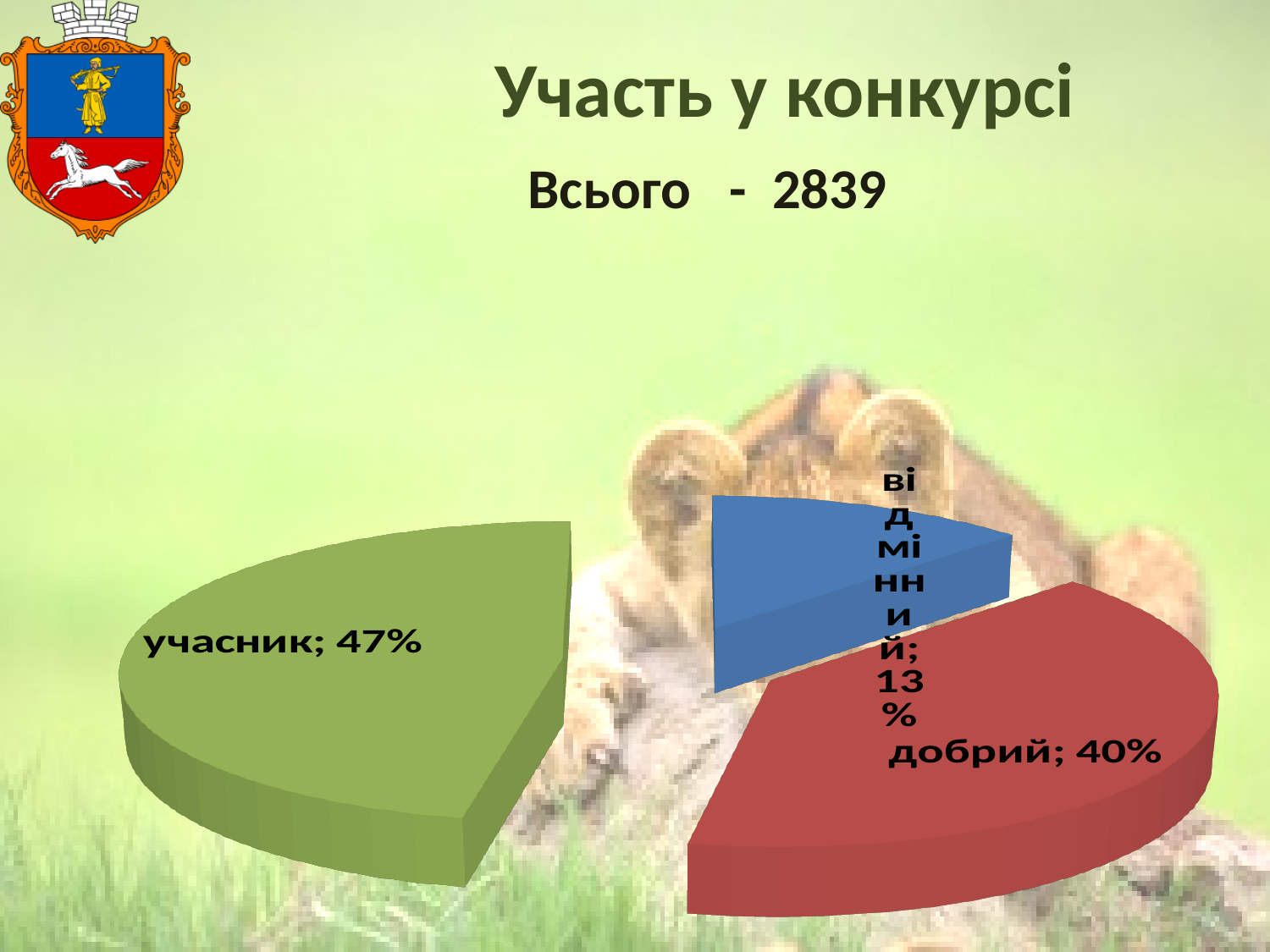
What total number is stated below the chart title? 2839 What share of the pie does the "відмінний" slice represent? 13% What is the title of the chart on the slide? Участь у конкурсі Which slice of the pie is the largest? учасник Which is larger, the "добрий" slice or the "відмінний" slice? добрий What share of the pie does the "добрий" slice represent? 40% What is the difference in percentage points between the "добрий" and "відмінний" slices? 27 What share of the pie does the "учасник" slice represent? 47% Which slice of the pie is the smallest? відмінний What kind of chart is shown on the slide? pie chart How many slices does the pie chart have? 3 What is the difference in percentage points between the "учасник" and "добрий" slices? 7